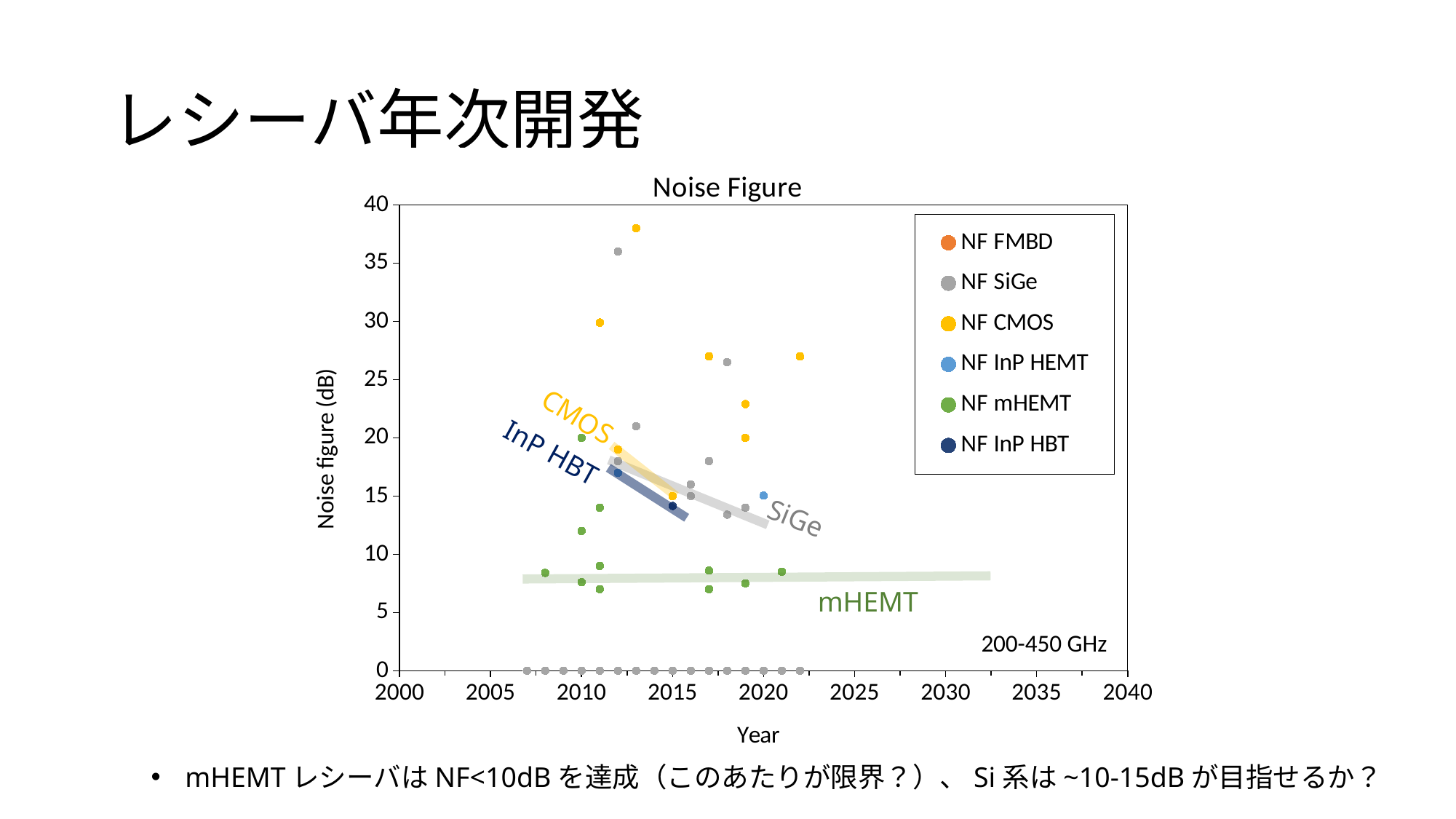
Is the NF InP HEMT point plotted at 2020 greater or less than 10? greater Does the SiGe trend line rise or fall as the year increases? fall Does the InP HBT trend line rise or fall as the year increases? fall Which series has the lowest plotted noise figure values above zero, NF mHEMT or NF CMOS? NF mHEMT What is the title of the chart? Noise Figure What frequency range is annotated in the lower right of the chart? 200-450 GHz Is the highest NF CMOS point greater or less than 35? greater Is the NF InP HBT point plotted at 2012 greater or less than 20? less How many series does the legend of the Noise Figure chart list? 6 What kind of chart is shown on the slide? scatter chart